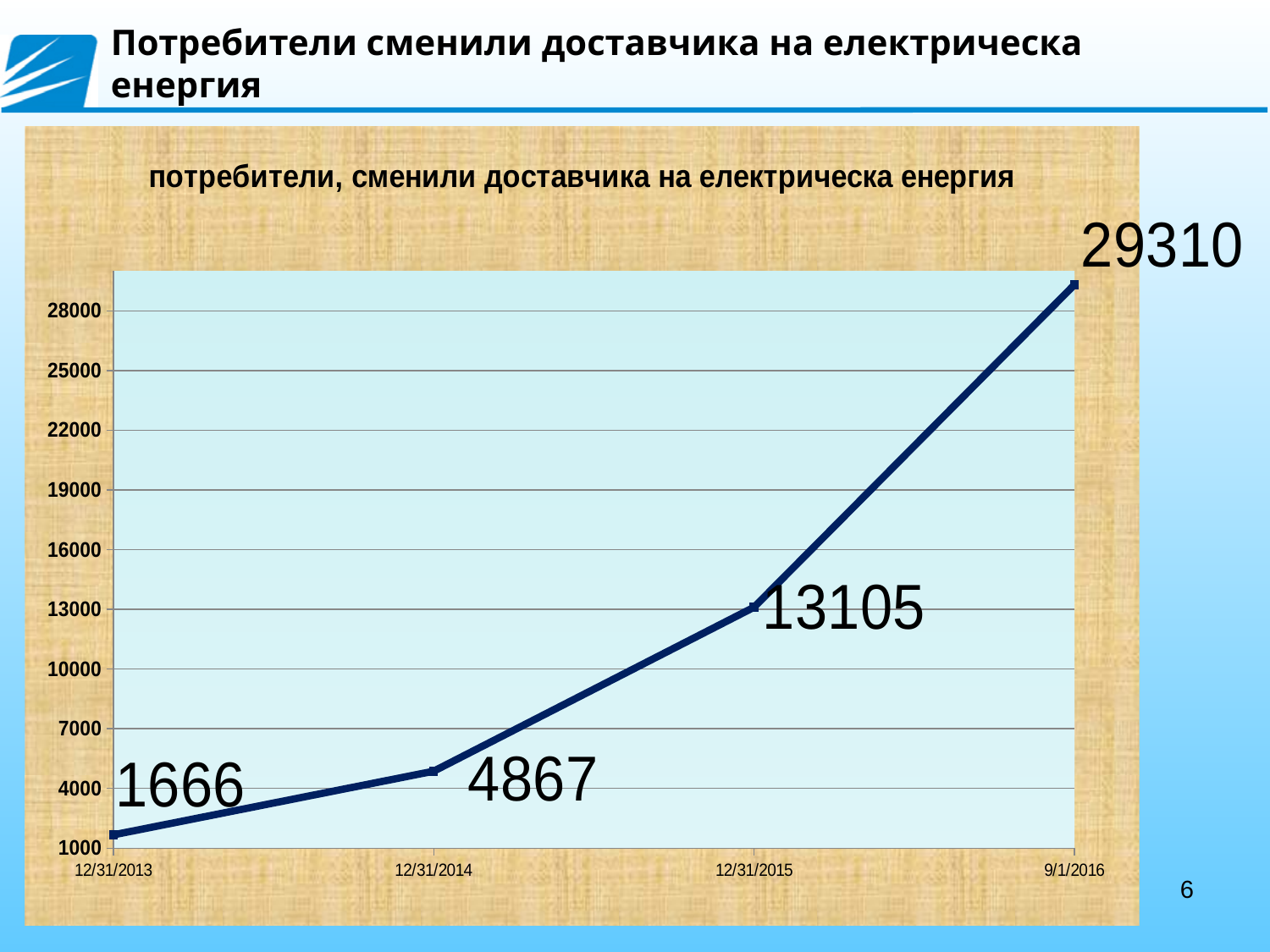
Which date has the lowest value? 12/31/2013 What is the value for 12/31/2013? 1666 What is the value for 9/1/2016? 29310 What is the difference between the values for 12/31/2014 and 12/31/2013? 3201 What kind of chart is shown on the slide? line chart Which date has the highest value? 9/1/2016 What is the difference between the values for 9/1/2016 and 12/31/2015? 16205 Do the values rise or fall from 12/31/2013 to 9/1/2016? rise How many data points are plotted on the chart? 4 What is the value for 12/31/2014? 4867 Which is larger, the value for 12/31/2015 or the value for 12/31/2014? 12/31/2015 What is the value for 12/31/2015? 13105